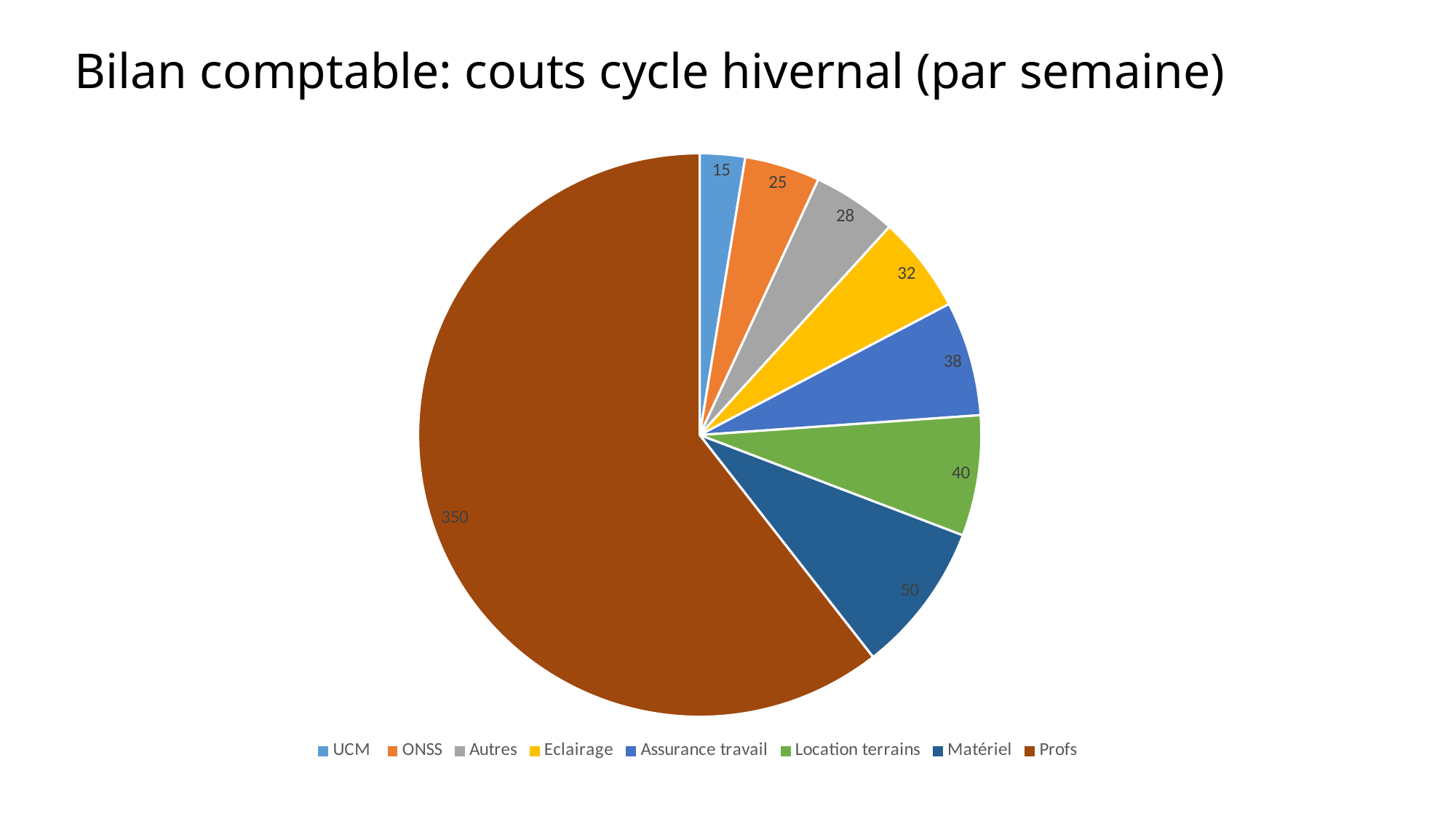
What is the value for Profs? 350 What is the total of all the slices in the pie chart? 578 What kind of chart is shown on the slide? pie chart Which category has the smallest slice? UCM What is the difference between the values for Matériel and Location terrains? 10 What is the title of the slide? Bilan comptable: couts cycle hivernal (par semaine) Which category has the largest slice? Profs How many categories does the pie chart have? 8 Which is larger, the value for Assurance travail or the value for ONSS? Assurance travail What is the value for Matériel? 50 What is the value for UCM? 15 What is the value for Eclairage? 32